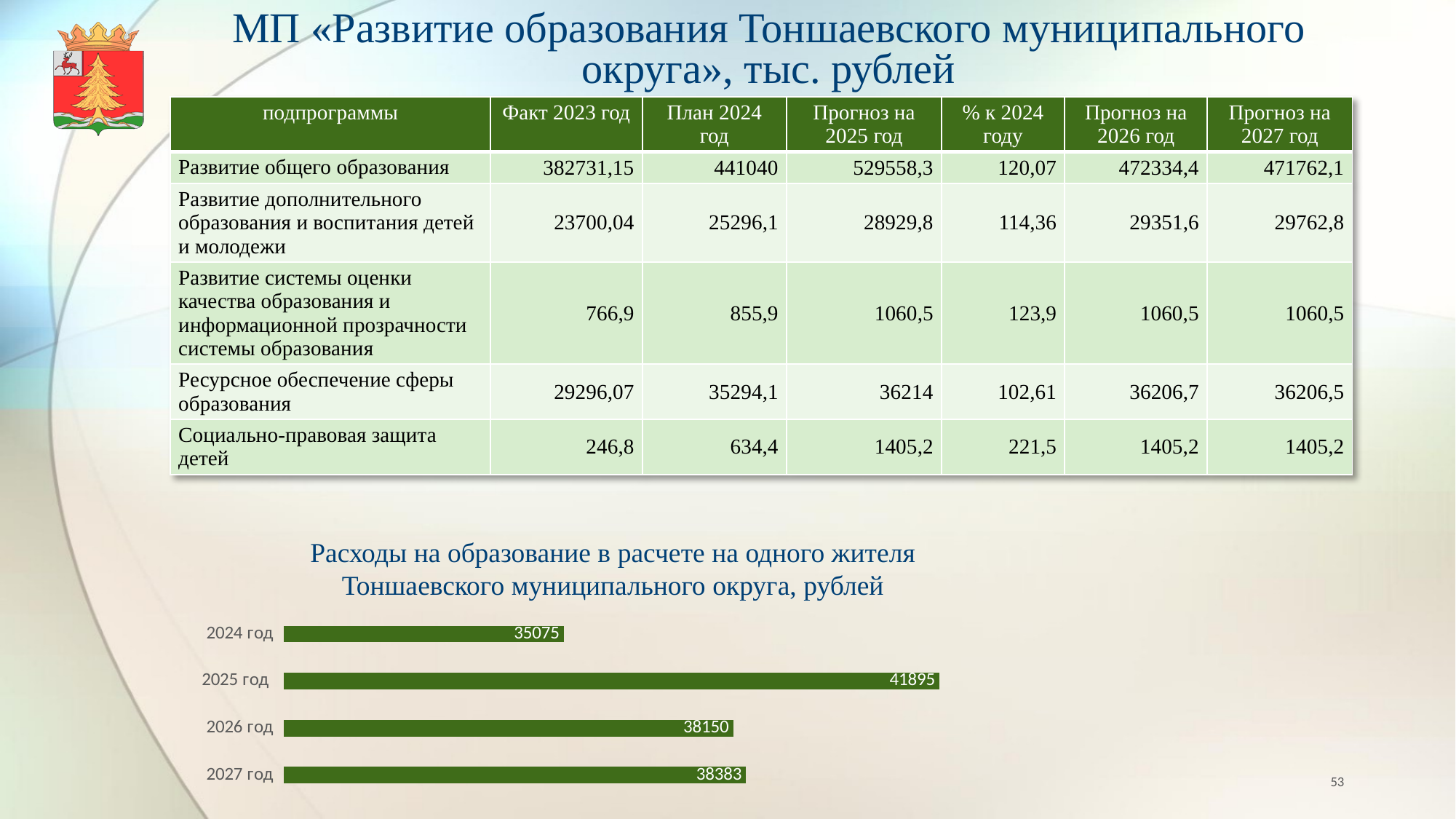
In the chart 'Расходы на образование в расчете на одного жителя', which year has the highest value? 2025 год In the chart 'Расходы на образование в расчете на одного жителя', does the value rise or fall from 2024 год to 2025 год? rise In the chart 'Расходы на образование в расчете на одного жителя', which year has the lowest value? 2024 год What is the value for 2026 год in the chart 'Расходы на образование в расчете на одного жителя'? 38150 In the chart 'Расходы на образование в расчете на одного жителя', which is larger: the value for 2025 год or the value for 2026 год? 2025 год What is the value for 2024 год in the chart 'Расходы на образование в расчете на одного жителя'? 35075 In the chart 'Расходы на образование в расчете на одного жителя', what is the difference between the values for 2025 год and 2024 год? 6820 How many bars are shown in the chart 'Расходы на образование в расчете на одного жителя'? 4 What type of chart is 'Расходы на образование в расчете на одного жителя Тоншаевского муниципального округа, рублей'? bar chart What is the value for 2025 год in the chart 'Расходы на образование в расчете на одного жителя Тоншаевского муниципального округа, рублей'? 41895 What is the value for 2027 год in the chart 'Расходы на образование в расчете на одного жителя'? 38383 In the chart 'Расходы на образование в расчете на одного жителя', what is the difference between the values for 2027 год and 2026 год? 233